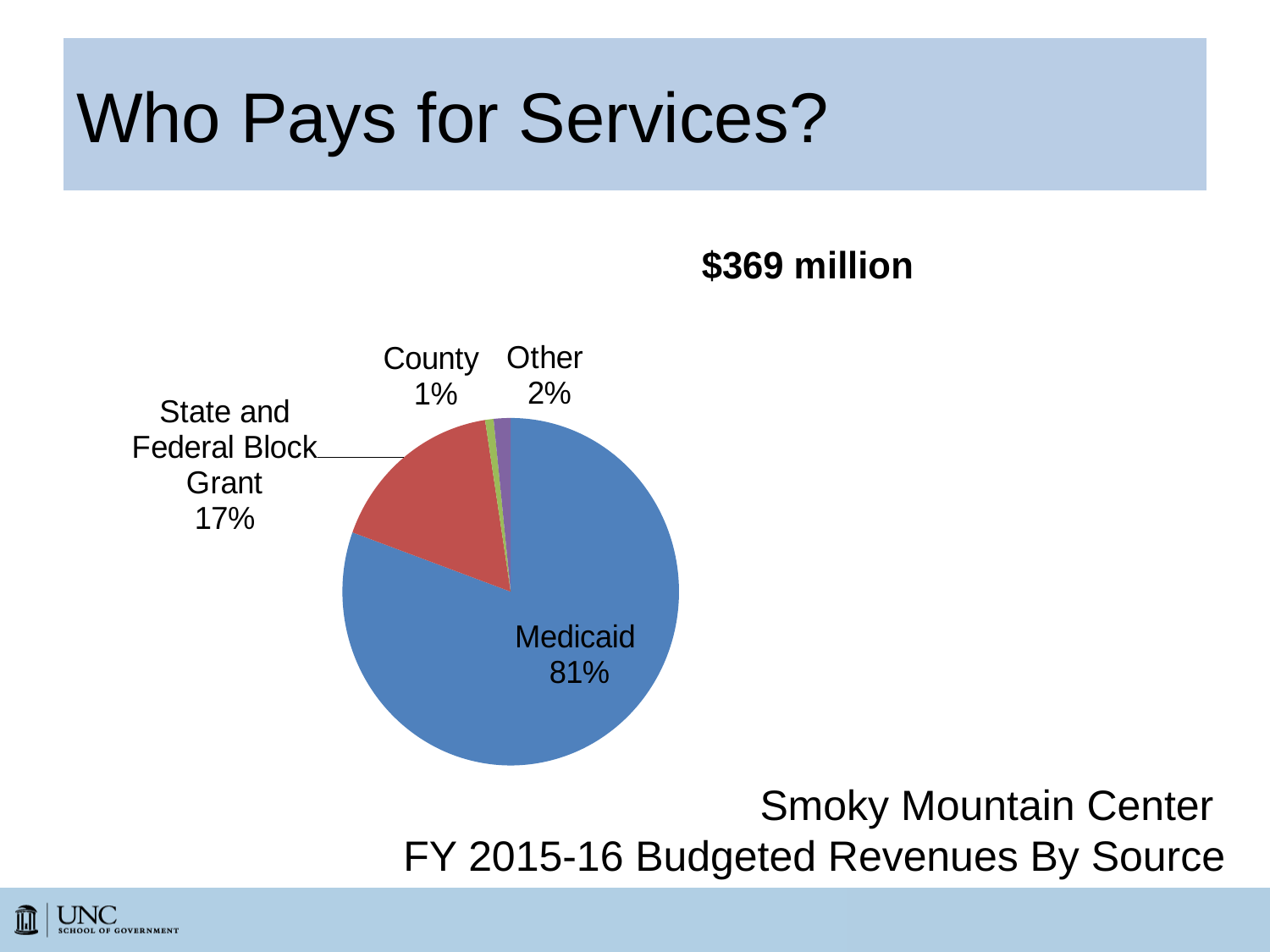
How many slices does the pie chart have? 4 What percentage is shown for State and Federal Block Grant? 17% Which revenue source has the largest slice of the pie? Medicaid What percentage is shown for County? 1% What total dollar amount is shown above the pie chart? $369 million What share of the pie does Medicaid account for? 81% What colour is the Medicaid slice? Blue What percentage is shown for Other? 2% Which is larger, the Other slice or the County slice? Other Which revenue source has the smallest slice of the pie? County What is the difference in percentage points between Medicaid and State and Federal Block Grant? 64 What kind of chart is shown on the slide? Pie chart